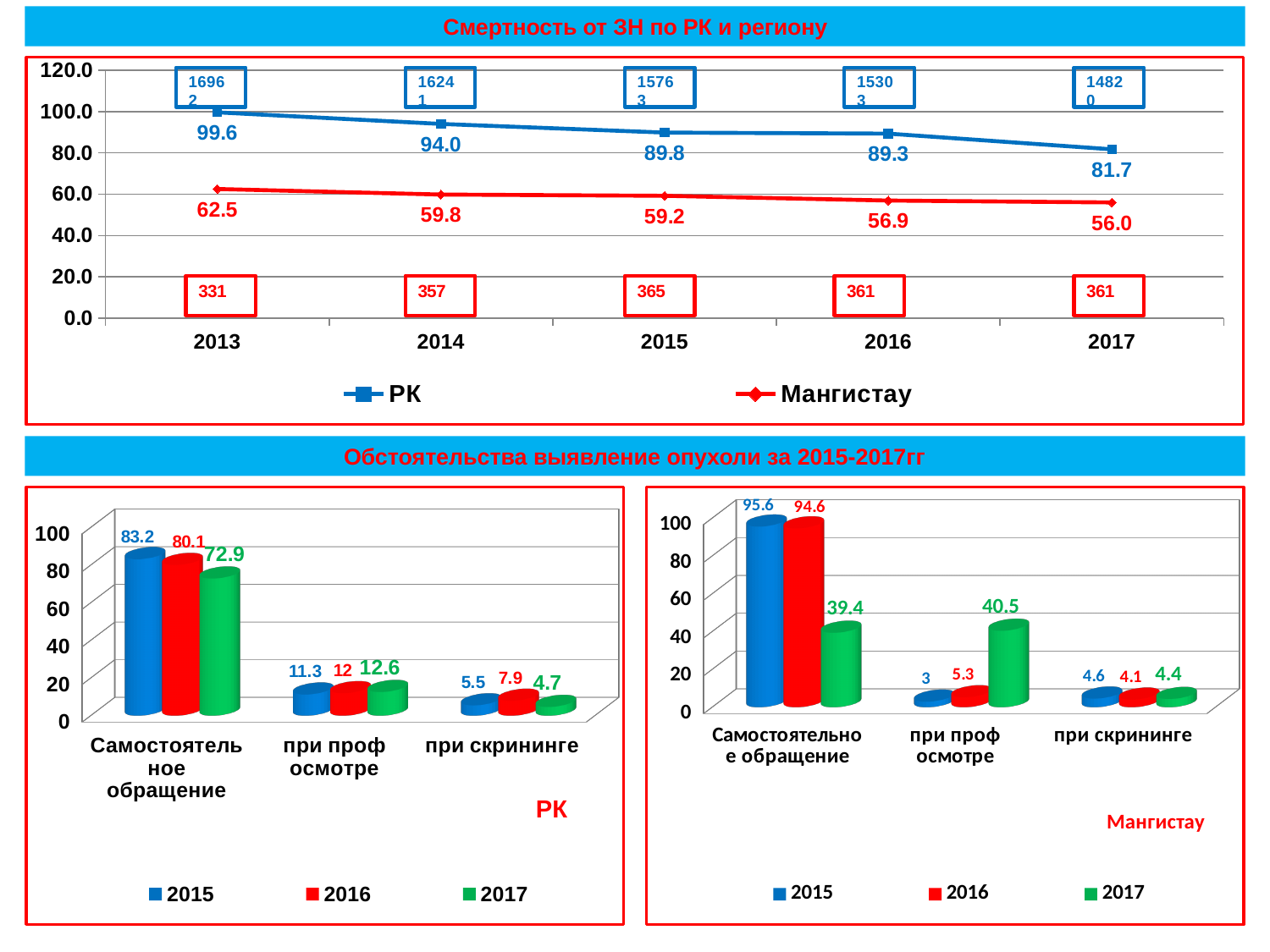
In the bottom-right bar chart (Мангистау), which is larger for 'при скрининге': the 2015 value or the 2016 value? 2015 In the top chart 'Смертность от ЗН по РК и региону', do the Мангистау values rise or fall from 2013 to 2017? fall What kind of chart is the top chart 'Смертность от ЗН по РК и региону'? line chart In the bottom-right bar chart (Мангистау), what is the 2017 value for 'при проф осмотре'? 40.5 In the bottom-right bar chart (Мангистау), what is the difference between the 2015 and 2017 values for 'Самостоятельное обращение'? 56.2 In the top chart 'Смертность от ЗН по РК и региону', what is the value for РК in 2013? 99.6 In the top chart 'Смертность от ЗН по РК и региону', what is the difference between the РК and Мангистау values in 2015? 30.6 In the top chart 'Смертность от ЗН по РК и региону', what is the value for Мангистау in 2017? 56.0 In the top chart 'Смертность от ЗН по РК и региону', how many series does the legend list? 2 In the bottom-left bar chart (РК), what is the 2017 value for 'Самостоятельное обращение'? 72.9 In the top chart 'Смертность от ЗН по РК и региону', in which year is the РК value lowest? 2017 In the bottom-left bar chart (РК), how many categories are shown on the x axis? 3